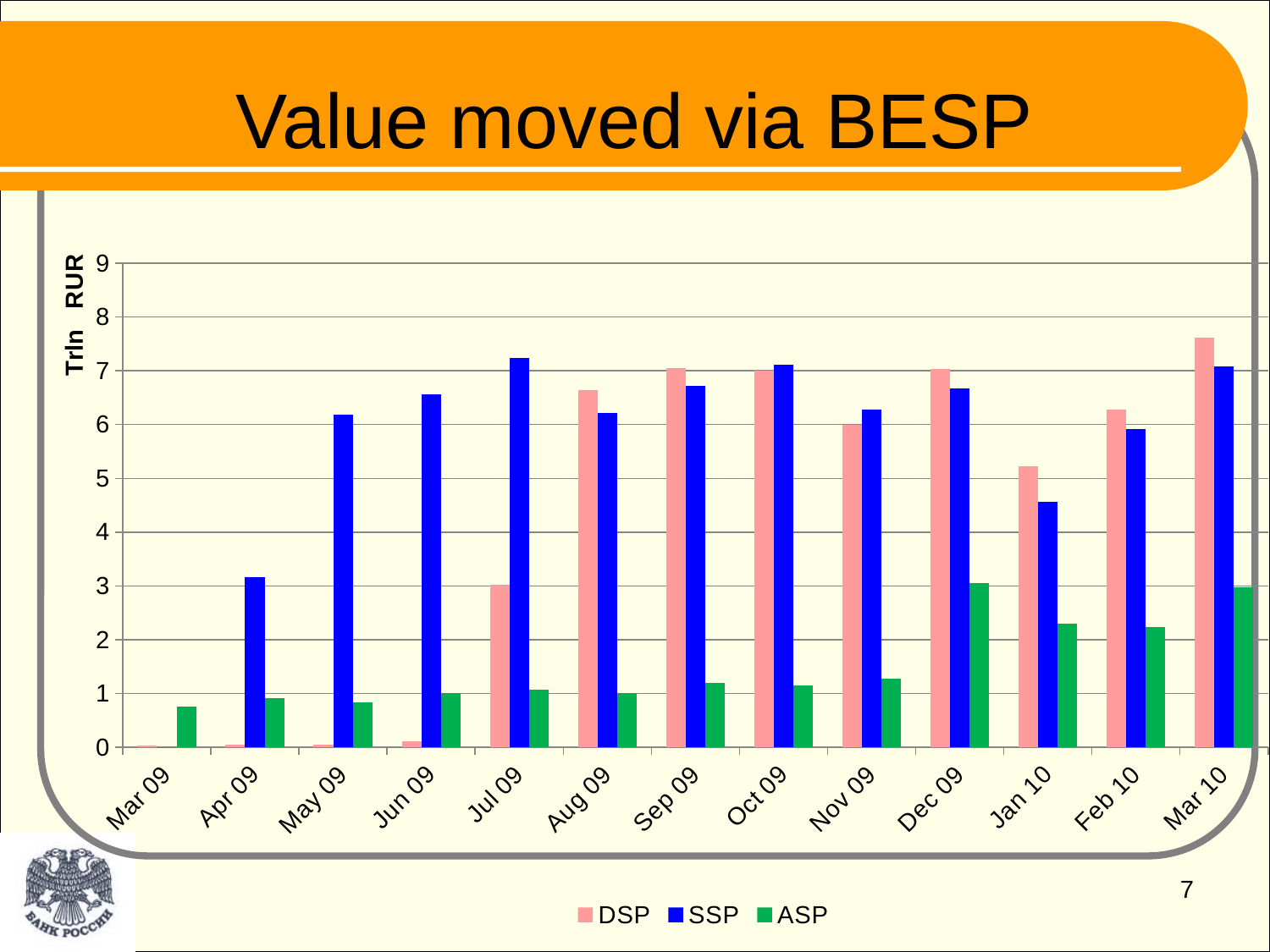
What is the label on the vertical axis? Trln RUR What kind of chart is shown on the slide? bar chart Is the ASP value for Jan 10 greater or less than 2? greater In which month is the DSP value highest? Mar 10 In Jan 10, which is larger, DSP or SSP? DSP How many series does the legend list? 3 Does the SSP value rise or fall from Mar 09 to Jul 09? rise Is the SSP value for Jan 10 greater or less than 5? less What is the title of the chart? Value moved via BESP Is the SSP value for Jul 09 greater or less than 7? greater How many months are shown on the x axis? 13